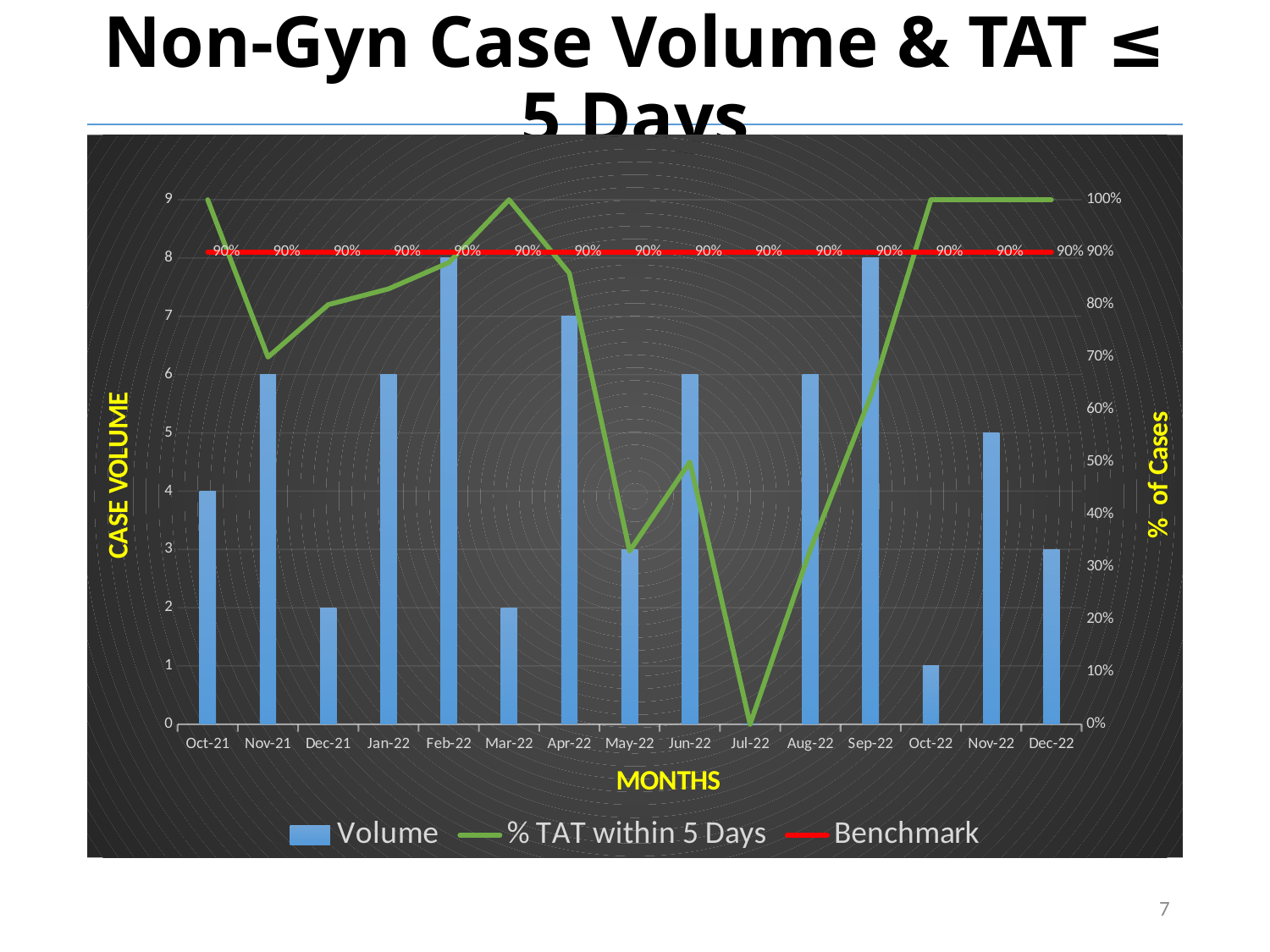
What is the case volume for Apr-22? 7 Which month has the lowest case volume? Jul-22 What is the case volume for Oct-22? 1 What is the case volume for Feb-22? 8 How many months are shown on the x axis? 15 Is the % TAT within 5 Days value for Nov-21 greater or less than 60%? greater Which month has the larger case volume, Nov-22 or Dec-22? Nov-22 What is the label of the left vertical axis? CASE VOLUME Is the % TAT within 5 Days value for May-22 greater or less than 50%? less What is the Benchmark value shown on the chart? 90% What is the difference in case volume between Sep-22 and Oct-22? 7 How many series does the legend list? 3